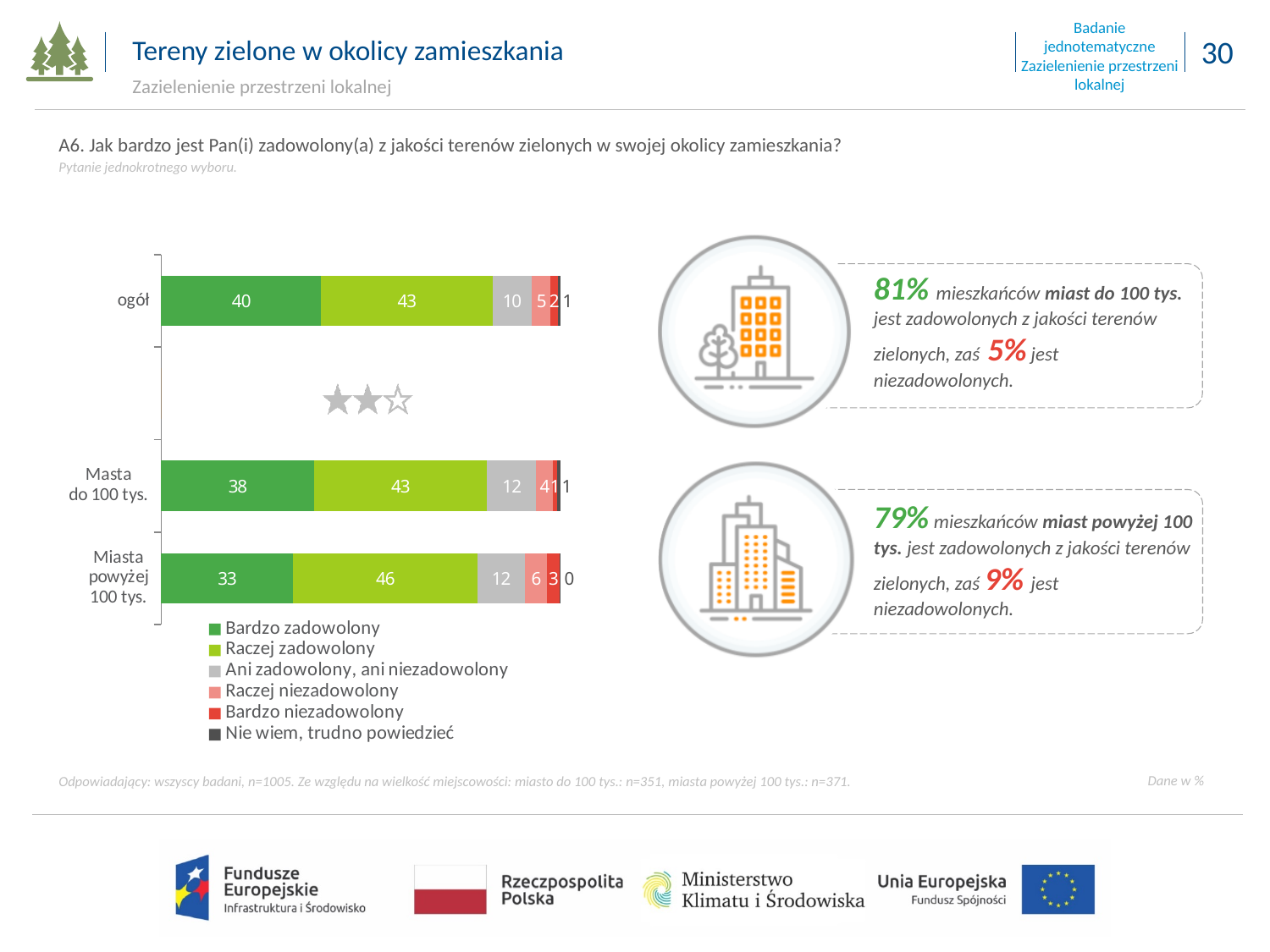
Which category has the lowest value for "Bardzo zadowolony"? Miasta powyżej 100 tys. What is the value of "Raczej niezadowolony" for "Miasta powyżej 100 tys."? 6 What kind of chart is shown on the slide? Stacked bar chart What is the value of "Raczej zadowolony" for "Miasta powyżej 100 tys."? 46 Which category has the highest value for "Bardzo zadowolony"? ogół What is the difference between the "Bardzo zadowolony" values for "ogół" and "Miasta powyżej 100 tys."? 7 What is the total of the stacked bar for "Miasta do 100 tys."? 99 Which is larger: "Raczej zadowolony" for "Miasta powyżej 100 tys." or for "Miasta do 100 tys."? Miasta powyżej 100 tys. How many series does the legend list? 6 How many categories are shown on the chart? 3 What is the value of "Bardzo zadowolony" for "ogół"? 40 What is the value of "Ani zadowolony, ani niezadowolony" for "Miasta do 100 tys."? 12